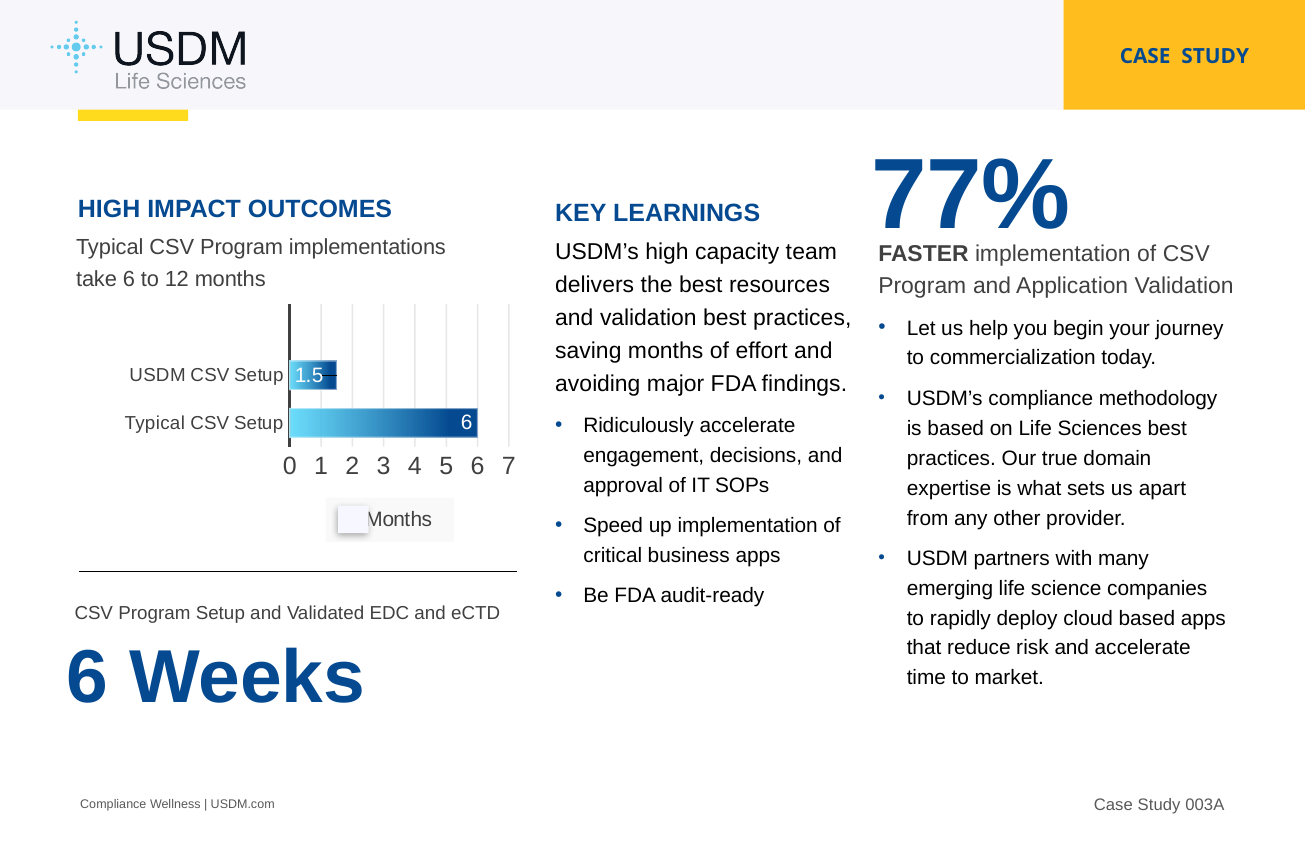
How many series does the legend list? 1 Is the value for USDM CSV Setup greater or less than 3? less How many categories are shown in the chart? 2 What kind of chart is shown on the slide? bar chart What is the value for USDM CSV Setup? 1.5 What is the legend entry for the series in the chart? Months Which category has the lowest value? USDM CSV Setup Which category has the highest value? Typical CSV Setup Which is larger, the value for USDM CSV Setup or Typical CSV Setup? Typical CSV Setup Is the value for Typical CSV Setup greater or less than 4? greater What is the difference between the Typical CSV Setup and USDM CSV Setup values? 4.5 What is the value for Typical CSV Setup? 6